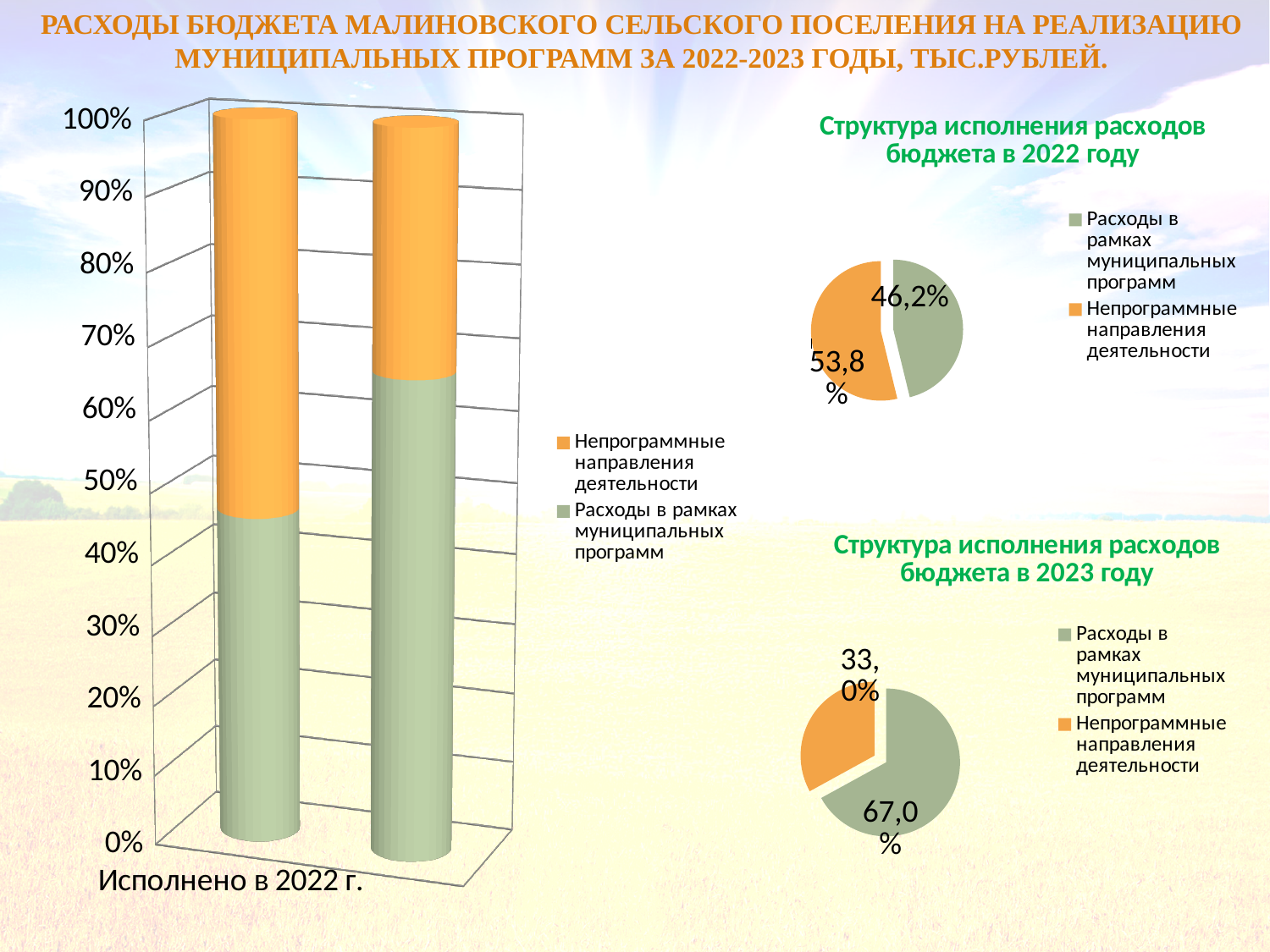
How many slices does the pie chart titled "Структура исполнения расходов бюджета в 2023 году" have? 2 In the bar chart on the left, is the share of "Расходы в рамках муниципальных программ" for "Исполнено в 2022 г." greater or less than 50%? less In the pie chart titled "Структура исполнения расходов бюджета в 2023 году", what share is shown for "Расходы в рамках муниципальных программ"? 67,0% In the pie chart titled "Структура исполнения расходов бюджета в 2023 году", what share is shown for "Непрограммные направления деятельности"? 33,0% In the pie chart titled "Структура исполнения расходов бюджета в 2022 году", what share is shown for "Непрограммные направления деятельности"? 53,8% What kind of chart is the large chart on the left side of the slide? Stacked bar chart In the pie chart titled "Структура исполнения расходов бюджета в 2022 году", what is the difference between the two slices? 7,6% How many series does the legend of the bar chart on the left list? 2 In the pie chart titled "Структура исполнения расходов бюджета в 2023 году", what is the difference between the two slices? 34,0% In the pie chart titled "Структура исполнения расходов бюджета в 2023 году", which slice is smaller? Непрограммные направления деятельности In the pie chart titled "Структура исполнения расходов бюджета в 2022 году", which slice is larger? Непрограммные направления деятельности